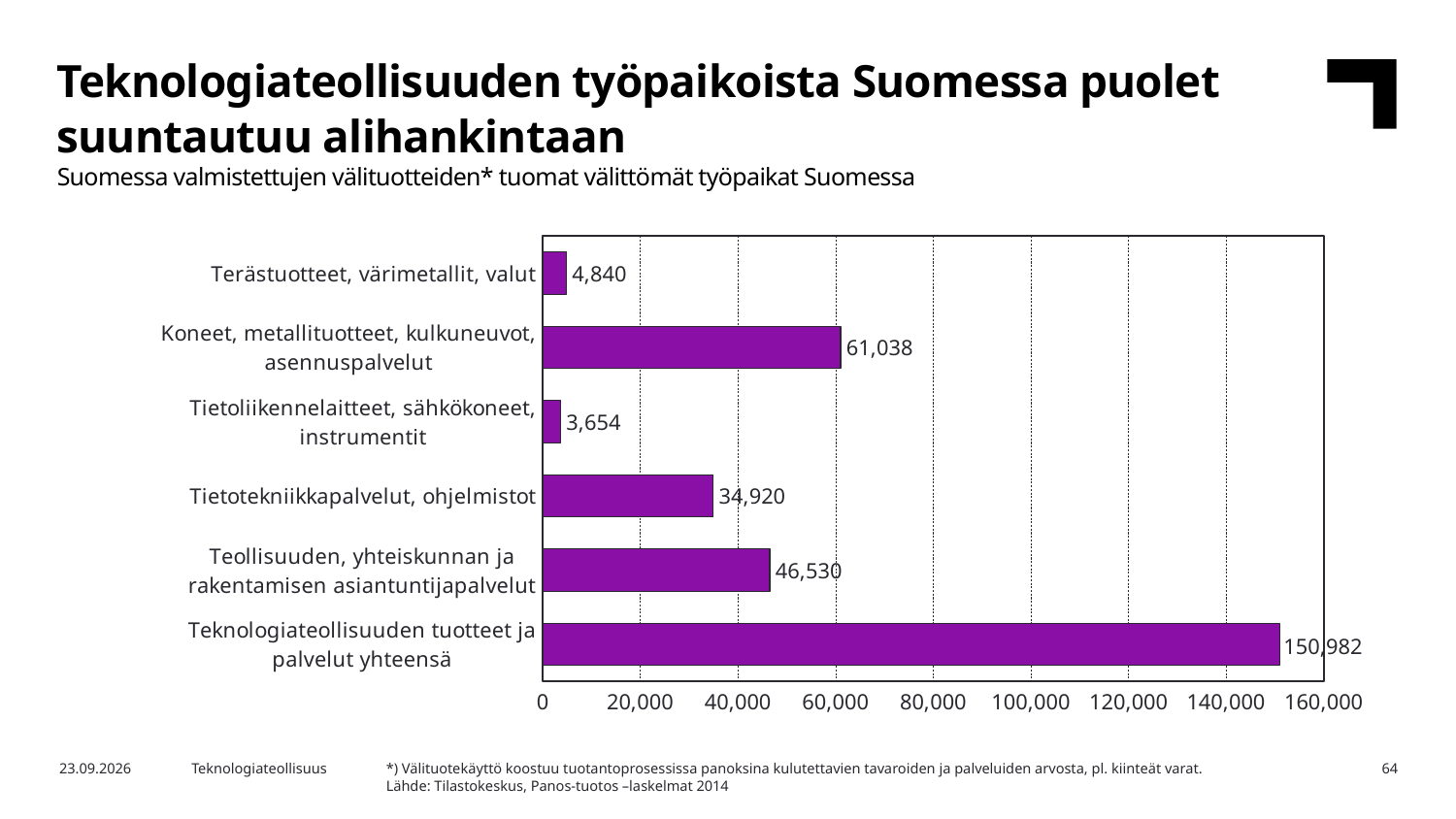
What is the value for Tietotekniikkapalvelut, ohjelmistot? 34,920 Which is larger: Teollisuuden, yhteiskunnan ja rakentamisen asiantuntijapalvelut or Tietotekniikkapalvelut, ohjelmistot? Teollisuuden, yhteiskunnan ja rakentamisen asiantuntijapalvelut What kind of chart is shown on the slide? bar chart How many categories are shown in the chart? 6 What is the difference between Terästuotteet, värimetallit, valut and Tietoliikennelaitteet, sähkökoneet, instrumentit? 1,186 Which category has the highest value? Teknologiateollisuuden tuotteet ja palvelut yhteensä What is the value for Tietoliikennelaitteet, sähkökoneet, instrumentit? 3,654 What is the value for Koneet, metallituotteet, kulkuneuvot, asennuspalvelut? 61,038 What is the difference between Koneet, metallituotteet, kulkuneuvot, asennuspalvelut and Tietotekniikkapalvelut, ohjelmistot? 26,118 Which category has the lowest value? Tietoliikennelaitteet, sähkökoneet, instrumentit Is the value for Teollisuuden, yhteiskunnan ja rakentamisen asiantuntijapalvelut greater or less than 40,000? greater What is the value for Teknologiateollisuuden tuotteet ja palvelut yhteensä? 150,982